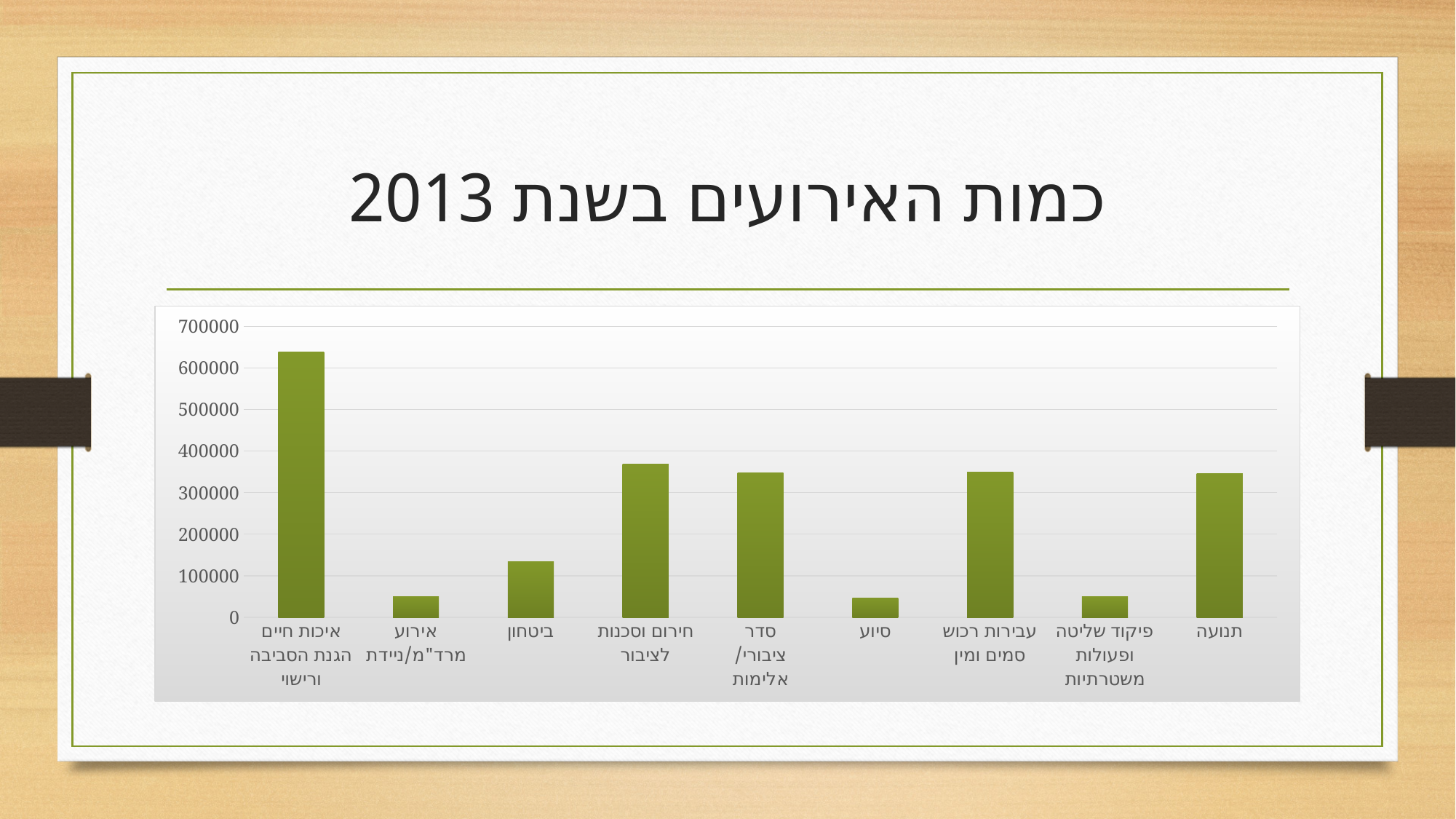
Is the value for חירום וסכנות לציבור greater or less than 300000? greater What is the highest value shown on the y axis of the chart? 700000 What is the title of the chart? כמות האירועים בשנת 2013 How many categories are shown on the x axis of the chart? 9 Is the value for סיוע greater or less than 100000? less Which is larger, the value for ביטחון or the value for סיוע? ביטחון Is the value for תנועה greater or less than 400000? less What kind of chart is shown on the slide? bar chart Which is larger, the value for חירום וסכנות לציבור or the value for פיקוד שליטה ופעולות משטרתיות? חירום וסכנות לציבור Which category has the highest value in the chart? איכות חיים הגנת הסביבה ורישוי